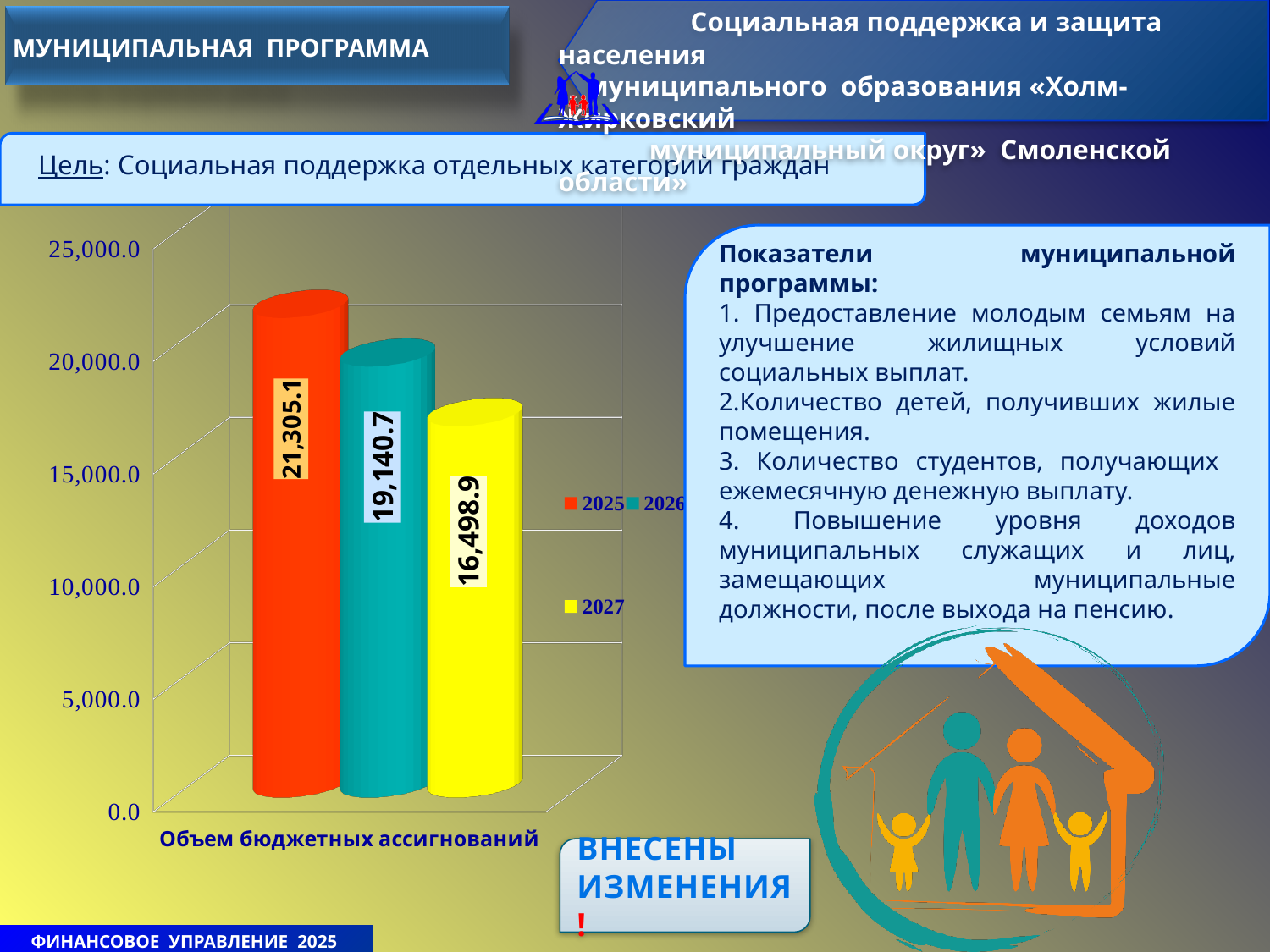
What type of chart is shown on the slide? bar chart What is the value of the 2027 bar in the chart? 16,498.9 Is the value for 2025 in the chart greater or less than 20,000.0? greater Which year has the highest value in the chart? 2025 Which is larger in the chart, the value for 2026 or the value for 2027? 2026 What is the value of the 2026 bar in the chart? 19,140.7 What is the difference between the 2025 and 2027 values in the chart? 4,806.2 How many series does the chart legend list? 3 Which year has the lowest value in the chart? 2027 What is the value of the 2025 bar in the chart? 21,305.1 What is the difference between the 2025 and 2026 values in the chart? 2,164.4 Do the values in the chart rise or fall from 2025 to 2027? fall